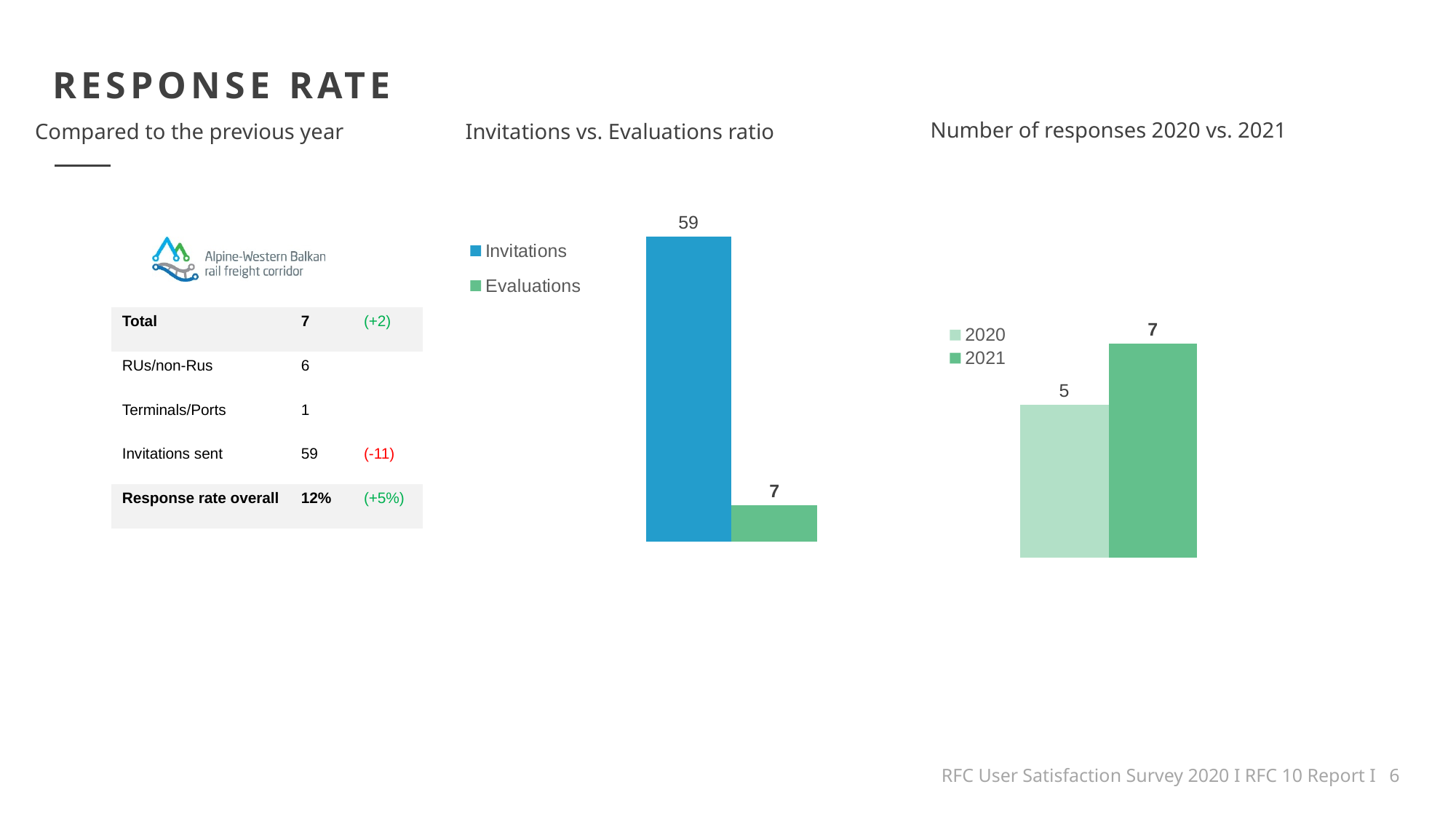
In the 'Invitations vs. Evaluations ratio' chart, what is the value for Evaluations? 7 In the 'Invitations vs. Evaluations ratio' chart, what colour is the Invitations bar? Blue In the 'Number of responses 2020 vs. 2021' chart, by how much did the number of responses increase from 2020 to 2021? 2 In the 'Number of responses 2020 vs. 2021' chart, what is the value for 2020? 5 In the 'Invitations vs. Evaluations ratio' chart, how many series does the legend list? 2 In the 'Invitations vs. Evaluations ratio' chart, what is the value for Invitations? 59 In the 'Invitations vs. Evaluations ratio' chart, which series has the higher value? Invitations In the 'Number of responses 2020 vs. 2021' chart, is the value for 2021 larger or smaller than the value for 2020? Larger In the 'Number of responses 2020 vs. 2021' chart, what is the value for 2021? 7 In the 'Number of responses 2020 vs. 2021' chart, which year has the lower value? 2020 In the 'Invitations vs. Evaluations ratio' chart, what is the difference between Invitations and Evaluations? 52 What kind of chart is the 'Invitations vs. Evaluations ratio' chart? Bar chart